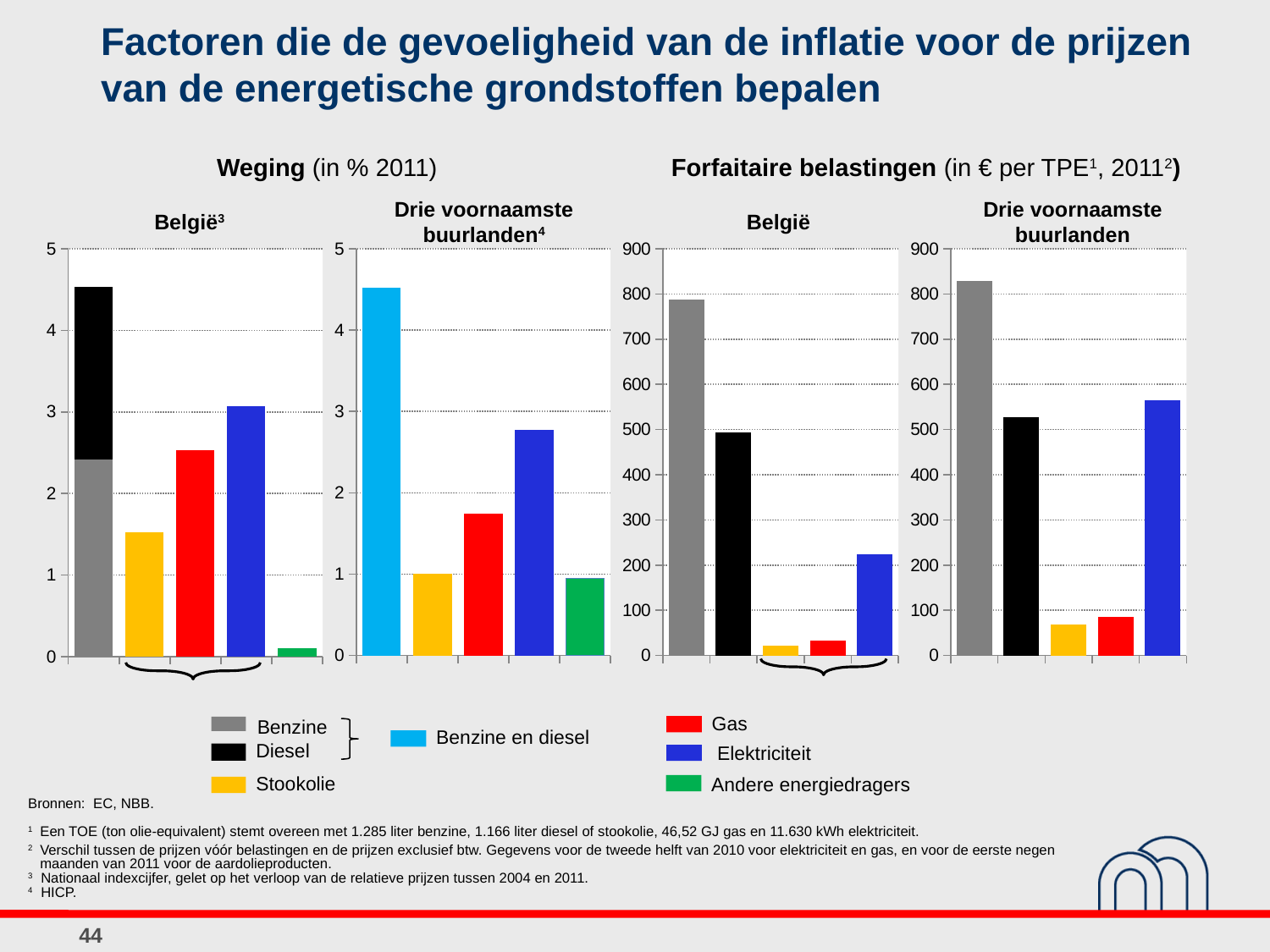
In the 'Weging' Drie voornaamste buurlanden chart, which category has the highest value? Benzine en diesel In the 'Forfaitaire belastingen' België chart, which is larger: Diesel or Elektriciteit? Diesel In the 'Forfaitaire belastingen' Drie voornaamste buurlanden chart, is the value for Elektriciteit greater or less than 500? greater In the 'Weging' België chart, is the value for Stookolie greater or less than 2? less In the 'Forfaitaire belastingen' België chart, is the value for Elektriciteit greater or less than 300? less In the 'Forfaitaire belastingen' België chart, which energy carrier has the highest value? Benzine In the 'Weging' België chart, which category has the lowest value? Andere energiedragers In the 'Weging' Drie voornaamste buurlanden chart, which is larger: Gas or Elektriciteit? Elektriciteit What kind of chart is used for the 'Forfaitaire belastingen' België panel? bar chart According to the legend, which colour represents Elektriciteit? blue How many bars are shown in the 'Forfaitaire belastingen' België chart? 5